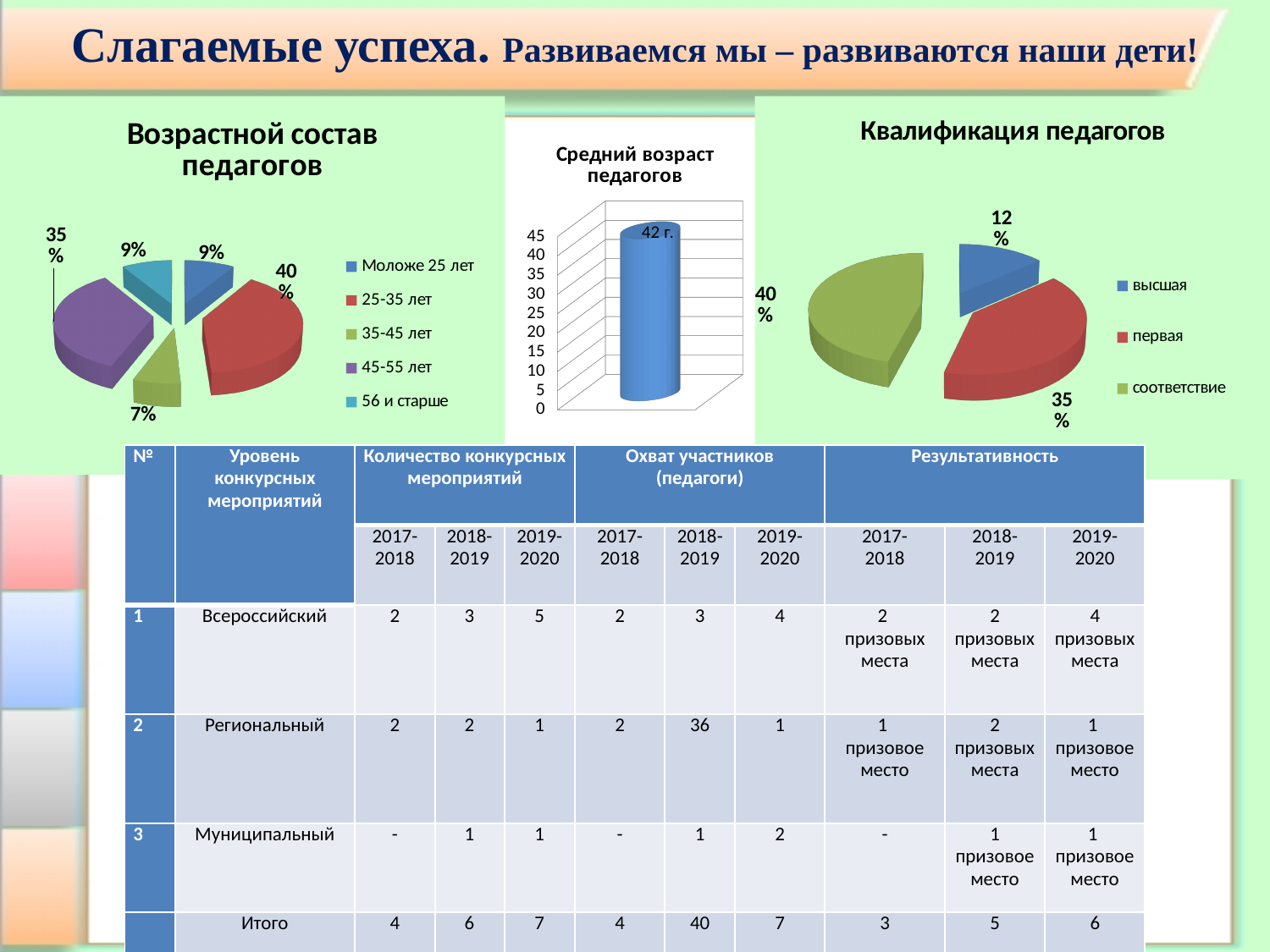
In the 'Квалификация педагогов' chart, what percentage of teachers have the 'высшая' category? 12% In the 'Квалификация педагогов' chart, what percentage of teachers have the 'первая' category? 35% In the 'Возрастной состав педагогов' chart, how many age groups does the legend list? 5 In the 'Квалификация педагогов' chart, which category has the largest share? соответствие In the 'Возрастной состав педагогов' chart, what percentage of teachers are aged 45-55 лет? 35% In the 'Средний возраст педагогов' chart, what value is shown on the bar? 42 г. In the 'Возрастной состав педагогов' chart, what is the difference between the shares for 25-35 лет and 45-55 лет? 5% In the 'Возрастной состав педагогов' chart, what percentage of teachers are aged 35-45 лет? 7% In the 'Возрастной состав педагогов' chart, which age group has the largest share? 25-35 лет In the 'Возрастной состав педагогов' chart, what percentage of teachers are aged 25-35 лет? 40% What kind of chart is 'Средний возраст педагогов'? Bar chart In the 'Возрастной состав педагогов' chart, which age group has the smallest share? 35-45 лет